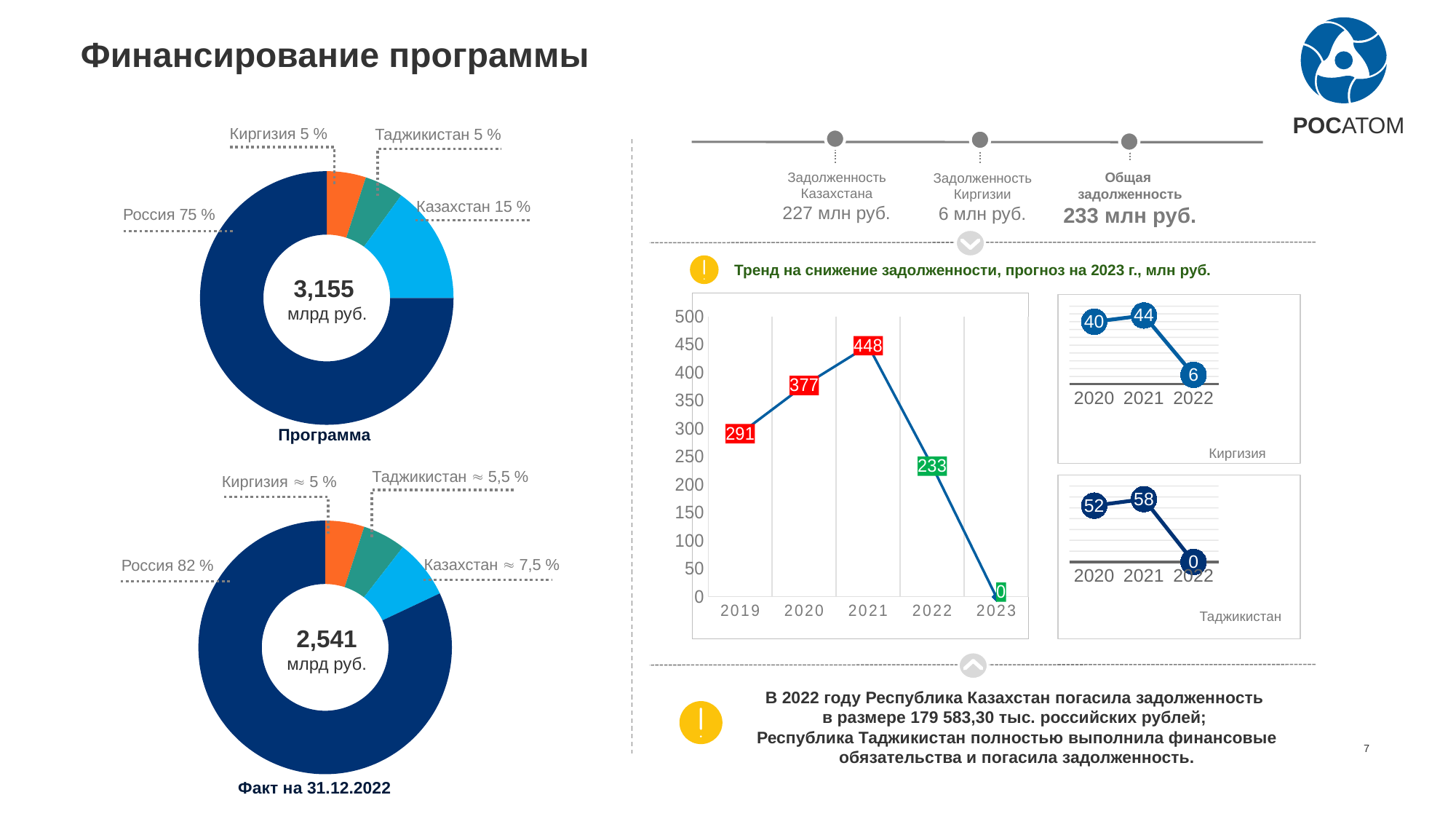
How many data points are plotted in the large line chart of debt trend (2019–2023)? 5 In the large line chart of debt trend (2019–2023), what is the value for 2021? 448 What total value is printed in the centre of the donut chart titled "Факт на 31.12.2022"? 2,541 млрд руб. In the donut chart titled "Факт на 31.12.2022", what share is shown for Россия? 82 % In the large line chart of debt trend (2019–2023), which year has the highest value? 2021 In the large line chart of debt trend (2019–2023), what is the difference between the values for 2021 and 2022? 215 In the large line chart of debt trend, do the values rise or fall from 2021 to 2023? fall In the donut chart titled "Программа", what is the difference between the shares of Россия and Казахстан? 60 % In the donut chart titled "Программа", which category has the largest share? Россия In the donut chart titled "Программа", what share is shown for Россия? 75 % Comparing the small charts, which is larger: the 2020 value for Таджикистан or the 2020 value for Киргизия? Таджикистан In the small line chart labelled "Киргизия", what is the value for 2022? 6